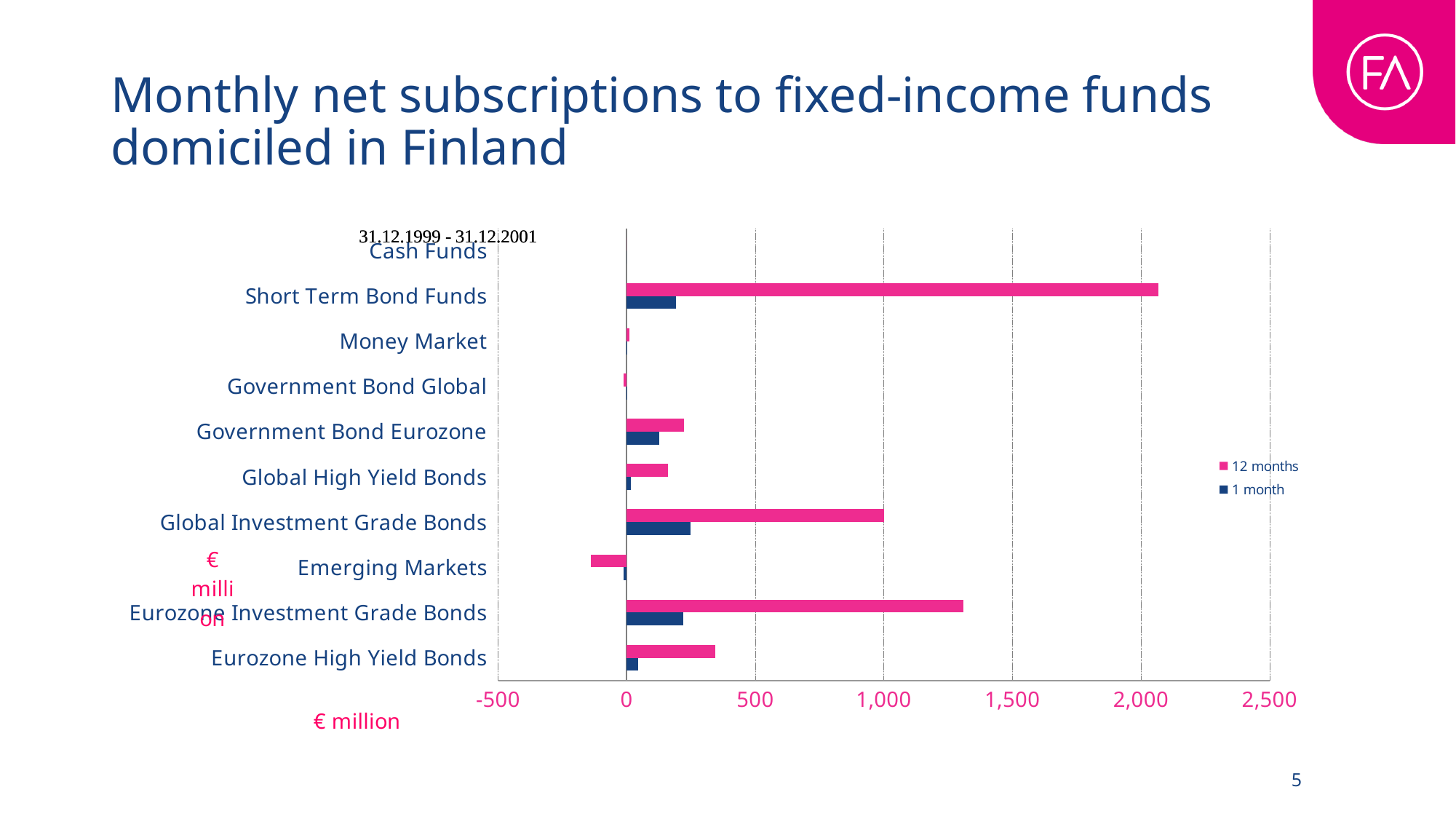
Is the 12 months value for Eurozone High Yield Bonds greater or less than 500? less What unit is shown on the horizontal axis label? € million Which category has the highest 12 months value? Short Term Bond Funds How many fund categories are shown on the vertical axis? 10 Is the 12 months value for Short Term Bond Funds greater or less than 2,000? greater Which is larger for Global Investment Grade Bonds, the 12 months value or the 1 month value? 12 months Which category has the lowest 12 months value? Emerging Markets How many series does the legend list? 2 What kind of chart is shown on the slide? bar chart Is the 12 months value for Emerging Markets greater or less than 0? less Which is larger, the 12 months value for Short Term Bond Funds or the 12 months value for Eurozone Investment Grade Bonds? Short Term Bond Funds